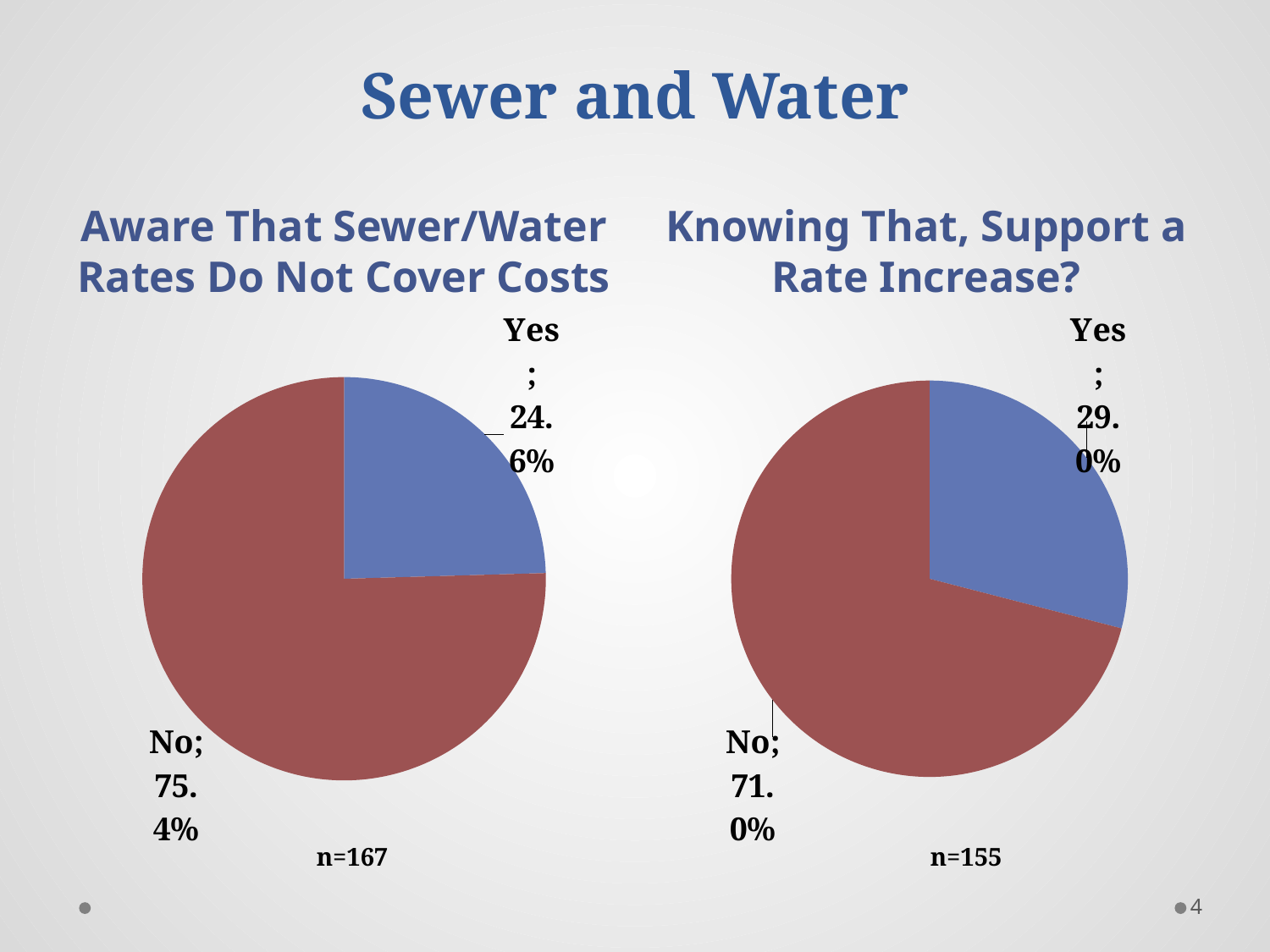
In the 'Knowing That, Support a Rate Increase?' chart, which response has the smallest share? Yes What kind of chart is used on the left side of the slide? Pie chart How many slices does the 'Knowing That, Support a Rate Increase?' pie chart have? 2 In the 'Aware That Sewer/Water Rates Do Not Cover Costs' chart, what percentage answered Yes? 24.6% In the 'Knowing That, Support a Rate Increase?' chart, what percentage answered Yes? 29.0% In the 'Knowing That, Support a Rate Increase?' chart, what is the difference between the No and Yes shares? 42.0% In the 'Aware That Sewer/Water Rates Do Not Cover Costs' chart, what is the difference between the No and Yes shares? 50.8% In the 'Aware That Sewer/Water Rates Do Not Cover Costs' chart, what percentage answered No? 75.4% What is the sample size (n) shown under the 'Knowing That, Support a Rate Increase?' chart? n=155 Which chart has the larger Yes share, the left chart or the right chart? The right chart In the 'Aware That Sewer/Water Rates Do Not Cover Costs' chart, which response has the largest share? No In the 'Knowing That, Support a Rate Increase?' chart, what percentage answered No? 71.0%